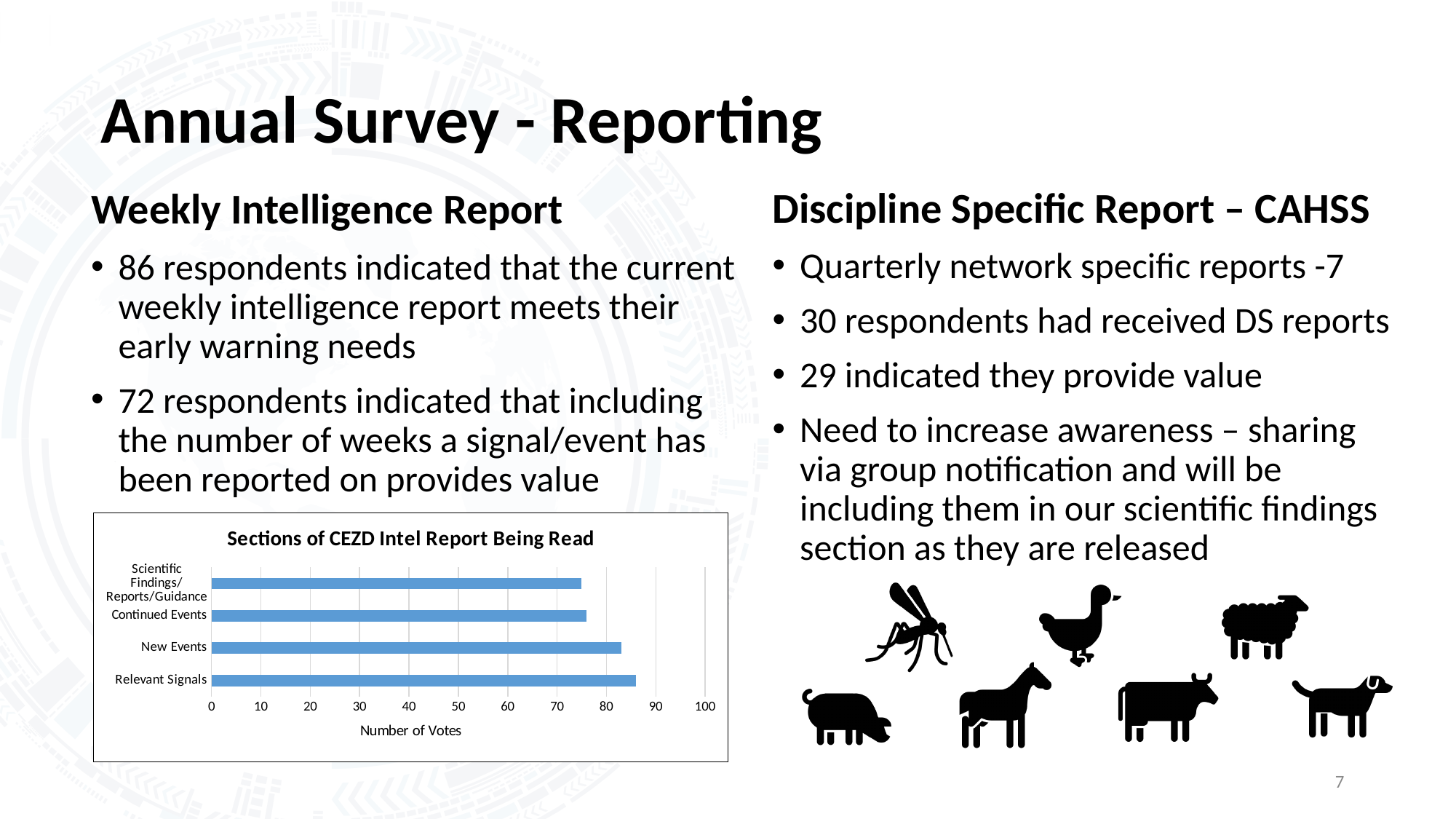
Is the value for New Events greater or less than 80? greater Which has more votes, New Events or Continued Events? New Events What type of chart is shown on the slide? bar chart Is the value for Scientific Findings/Reports/Guidance greater or less than 70? greater Which section received the highest number of votes in the chart? Relevant Signals How many categories are plotted in the chart? 4 What is the label of the horizontal axis of the chart? Number of Votes Is the value for Continued Events greater or less than 80? less What is the title of the chart on the slide? Sections of CEZD Intel Report Being Read Which has more votes, Relevant Signals or Scientific Findings/Reports/Guidance? Relevant Signals